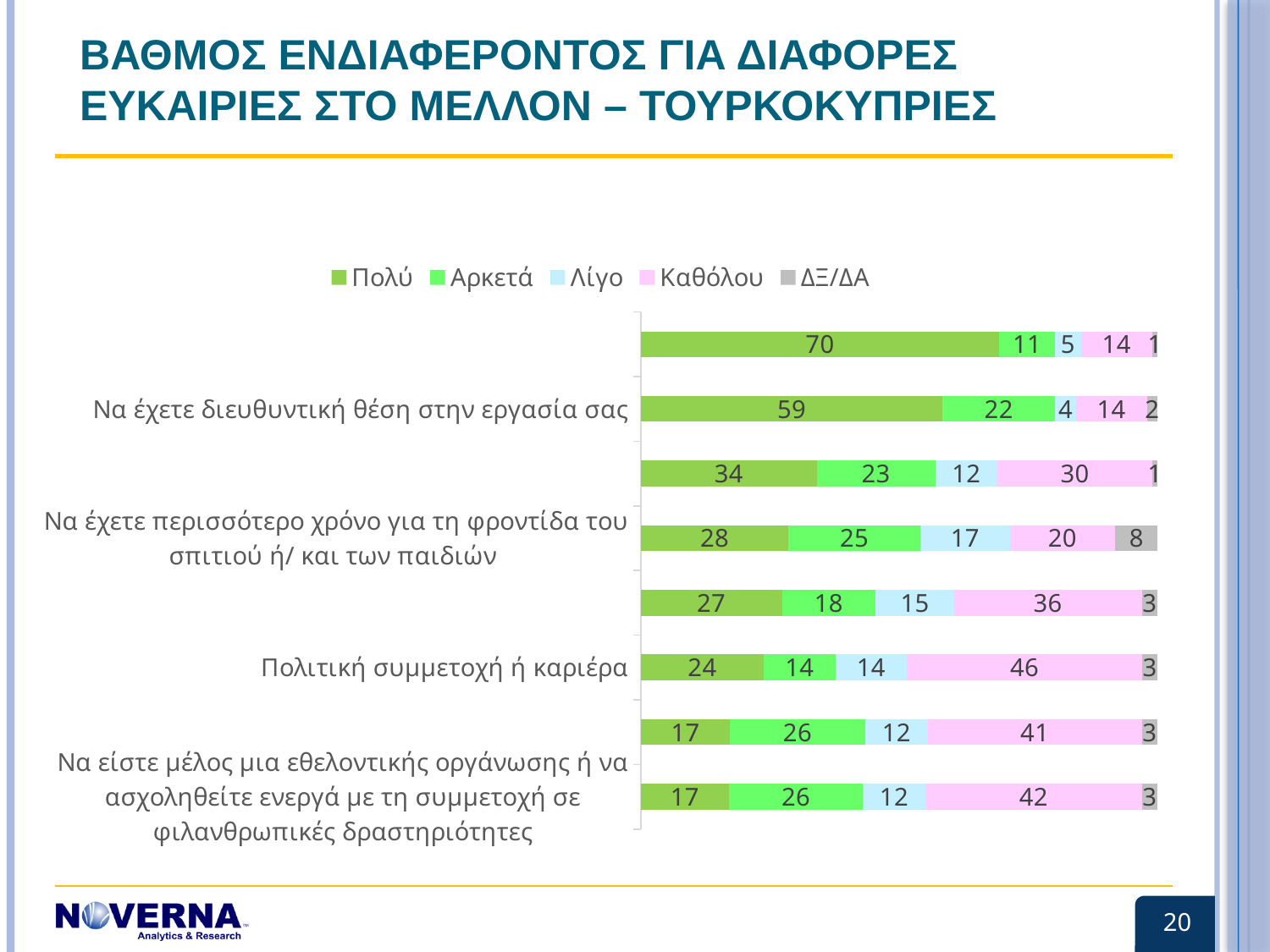
Which bar has the highest Πολύ value? the top bar (70) What is the difference between the Πολύ values of the top bar and the second bar from the top? 11 In the fifth bar from the top, which is larger: the Πολύ value or the Καθόλου value? Καθόλου What is the Καθόλου value for the bottom bar? 42 What is the Πολύ value for the top bar? 70 How many series does the legend list? 5 How many bars are plotted in the chart? 8 What kind of chart is shown on the slide? stacked bar chart Which bar has the highest Καθόλου value? the sixth bar from the top (46) Do the Πολύ values rise or fall going from the top bar to the bottom bar? fall What is the ΔΞ/ΔΑ value for the fourth bar from the top? 8 What is the Λίγο value for the third bar from the top? 12